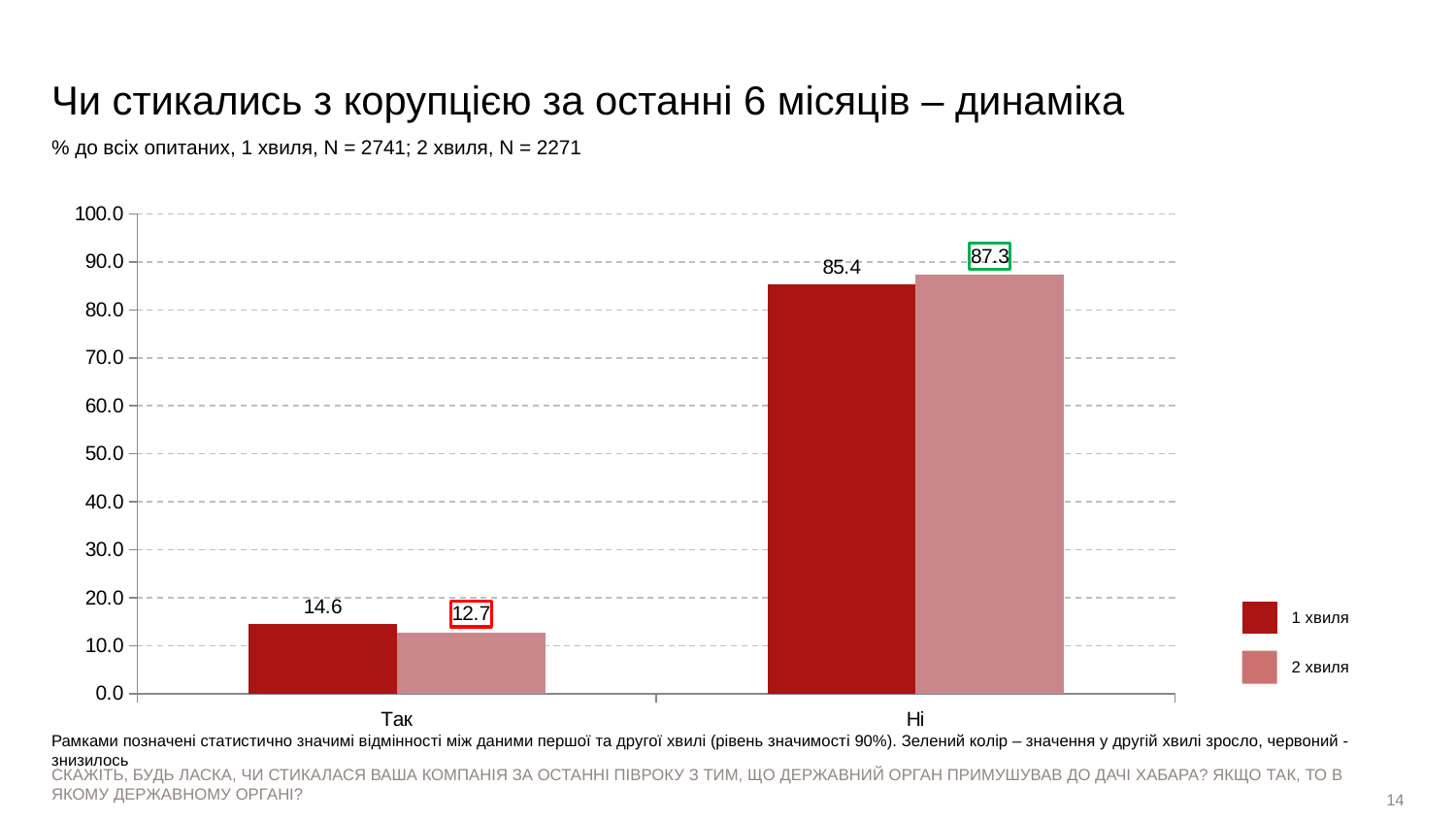
For "Ні", which series has the larger value, "1 хвиля" or "2 хвиля"? 2 хвиля What is the value for "Ні" in the "2 хвиля" series? 87.3 What is the value for "Так" in the "2 хвиля" series? 12.7 How many series does the legend list? 2 What is the difference between the "2 хвиля" and "1 хвиля" values for "Ні"? 1.9 What is the difference between the "1 хвиля" and "2 хвиля" values for "Так"? 1.9 How many categories are shown on the x axis? 2 What is the value for "Ні" in the "1 хвиля" series? 85.4 Which category has the highest value in the "2 хвиля" series? Ні What is the value for "Так" in the "1 хвиля" series? 14.6 Which category has the lowest value in the "1 хвиля" series? Так What kind of chart is shown on the slide? Bar chart